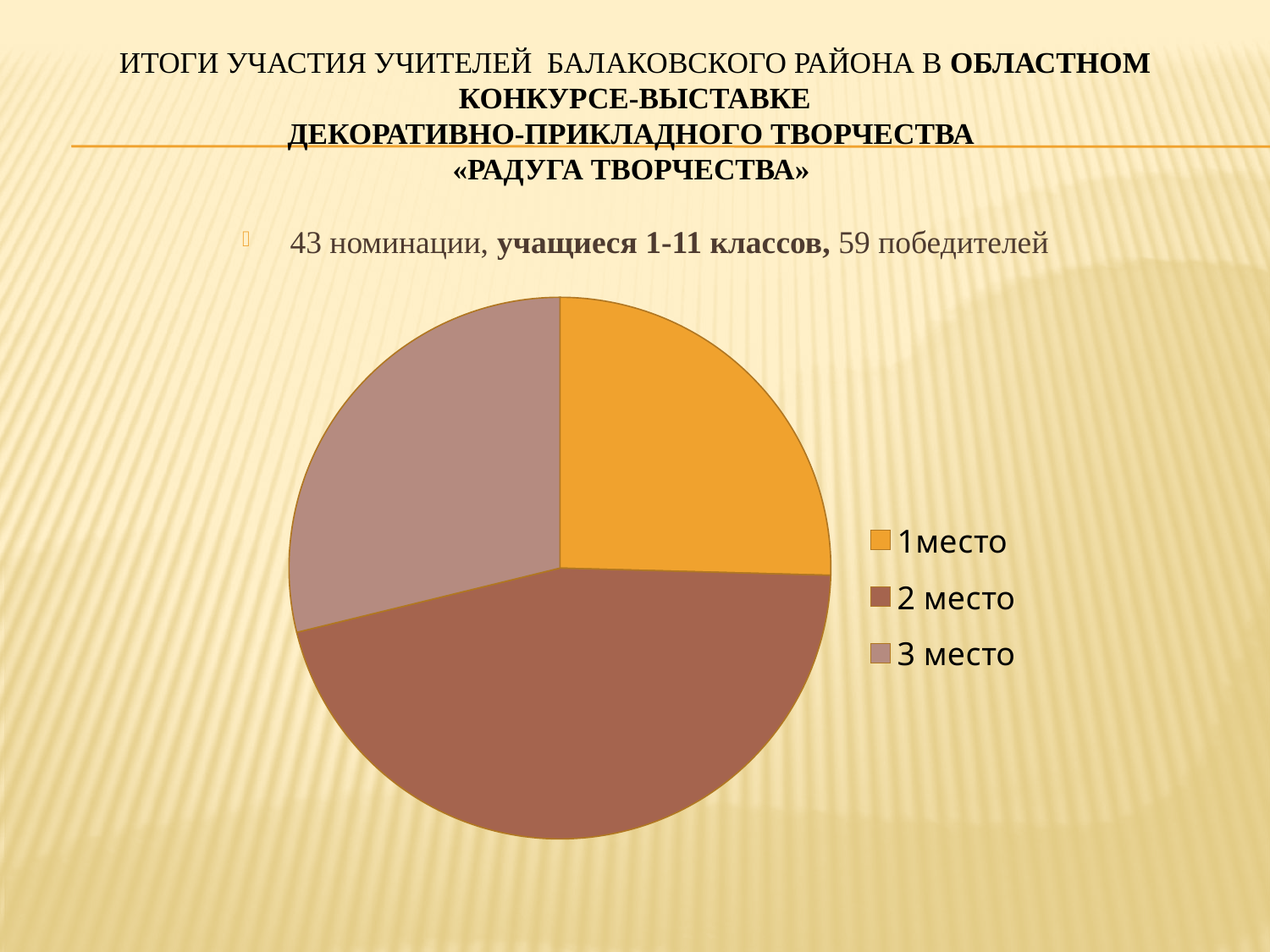
What kind of chart is shown on the slide? pie chart Which category has the largest slice of the pie chart? 2 место Which slice is larger, 2 место or 1 место? 2 место What colour is the slice for 1 место in the pie chart? orange Which slice is larger, 2 место or 3 место? 2 место How many entries does the legend of the pie chart list? 3 How many slices does the pie chart have? 3 Which legend entry is shown in brown? 2 место